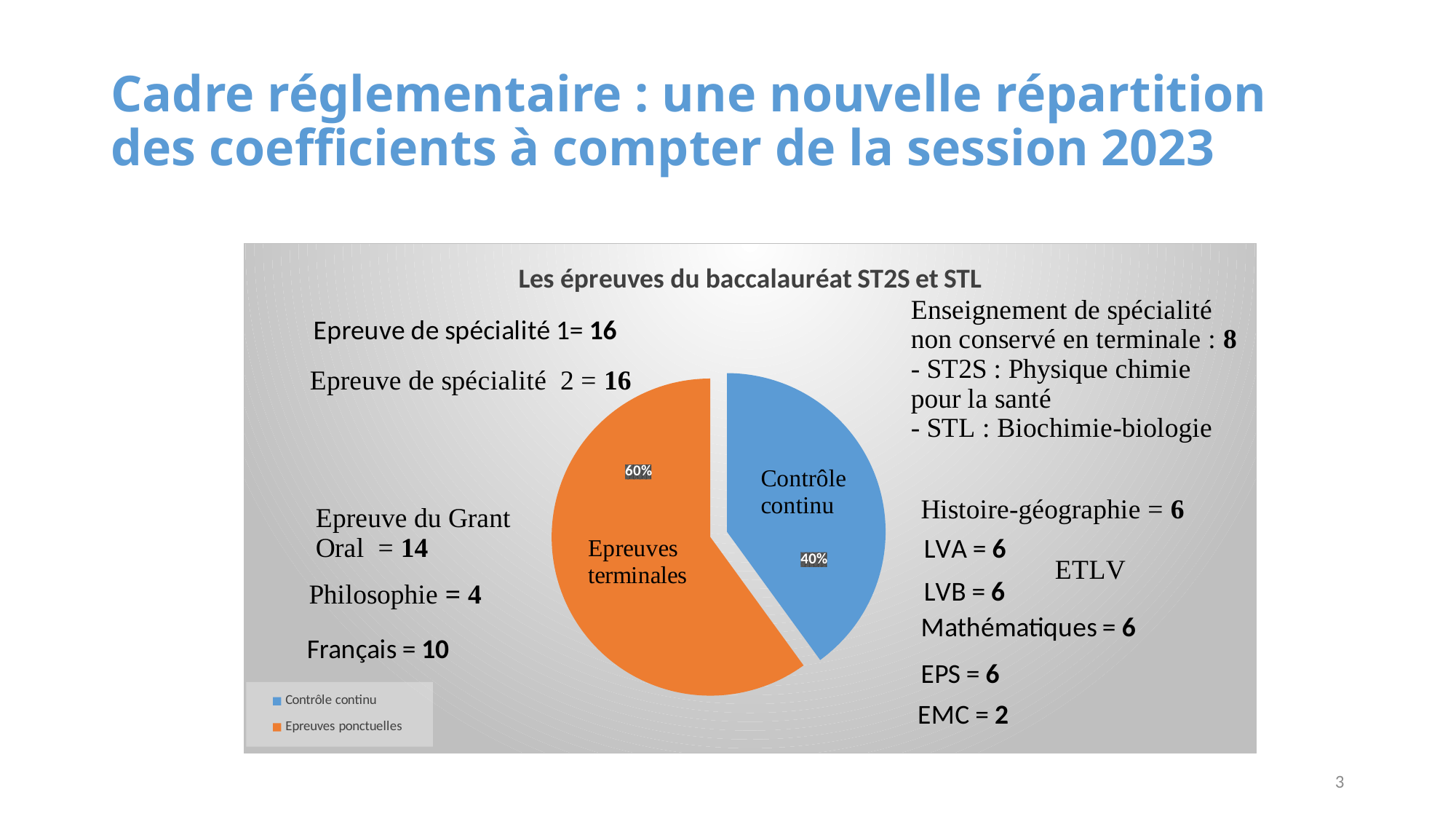
What colour is the Contrôle continu slice? blue What is the difference in percentage points between the Epreuves ponctuelles slice and the Contrôle continu slice? 20% Is the share for Contrôle continu greater or less than 50%? less What is the title of the chart? Les épreuves du baccalauréat ST2S et STL What share of the pie does Epreuves ponctuelles (Epreuves terminales) represent? 60% Which slice of the pie is the smallest? Contrôle continu What kind of chart is shown on the slide? pie chart What share of the pie does Contrôle continu represent? 40% How many entries does the chart legend list? 2 Which is larger, the Contrôle continu slice or the Epreuves ponctuelles slice? Epreuves ponctuelles Which slice of the pie is the largest? Epreuves ponctuelles How many slices does the pie chart have? 2